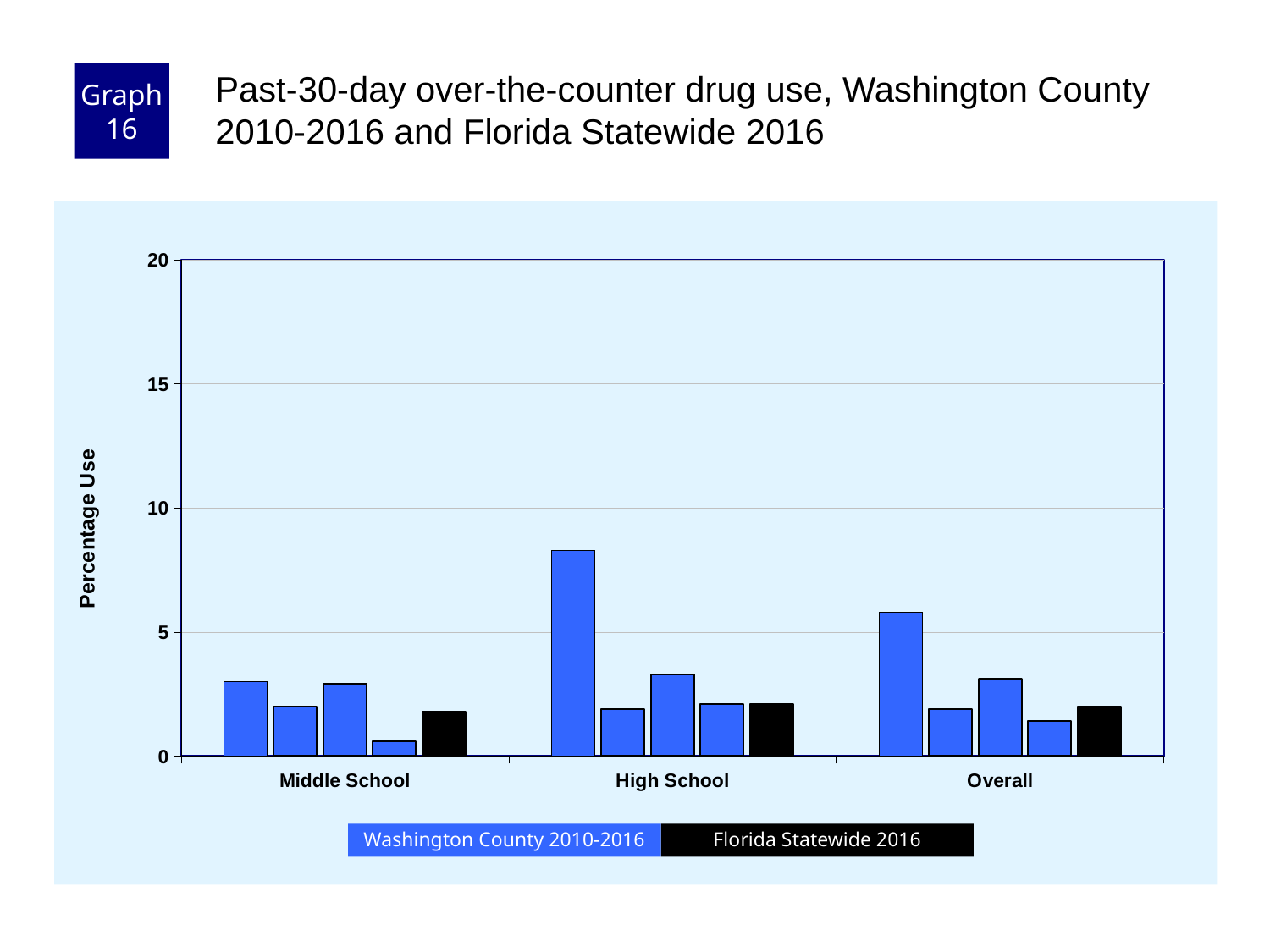
Which category contains the shortest bar in the chart? Middle School How many categories are shown on the x axis? 3 What kind of chart is shown on the slide? bar chart What is the label on the y axis? Percentage Use What colour represents Florida Statewide 2016 in the legend? black Which is taller, the tallest Washington County 2010-2016 bar for High School or the tallest Washington County 2010-2016 bar for Overall? High School Is the tallest Washington County 2010-2016 bar for High School greater or less than 10? less How many series does the legend list? 2 Is the tallest Washington County 2010-2016 bar for High School greater or less than 5? greater Which category contains the tallest bar in the chart? High School Is the Florida Statewide 2016 bar for Middle School greater or less than 5? less